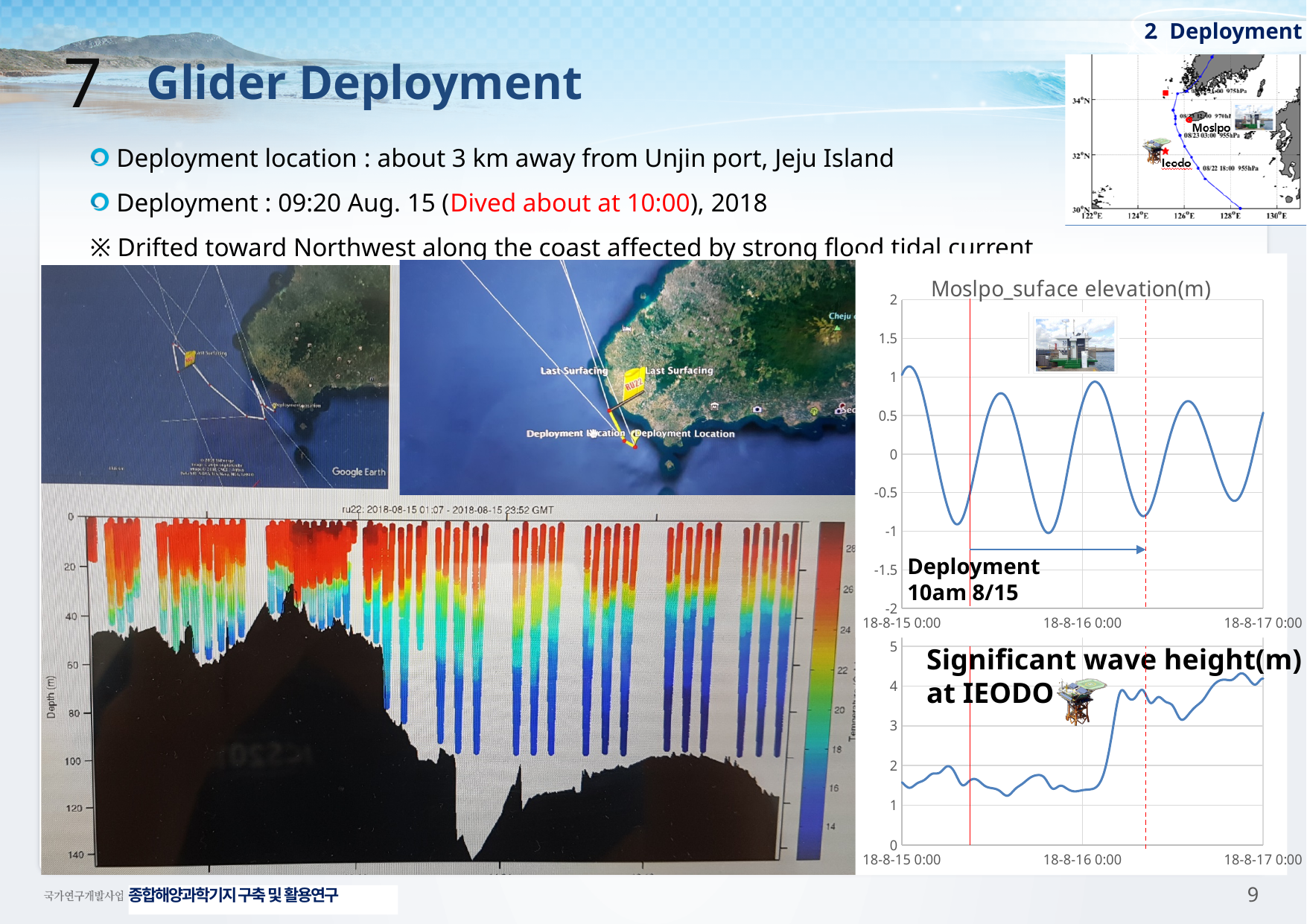
What is the title of the upper line chart on the right side of the slide? Moslpo_suface elevation(m) In the 'Moslpo_suface elevation(m)' chart, is the value at 18-8-15 0:00 greater or less than 0.5? greater What is the highest value shown on the y axis of the 'Significant wave height(m) at IEODO' chart? 5 In the 'Significant wave height(m) at IEODO' chart, do the values overall rise or fall from 18-8-15 0:00 to 18-8-17 0:00? rise What kind of chart is the 'Moslpo_suface elevation(m)' chart? line chart In the 'Moslpo_suface elevation(m)' chart, is the value at 18-8-16 0:00 greater or less than 0? greater How many line charts are shown on the right side of the slide? 2 In the 'Significant wave height(m) at IEODO' chart, is the value at 18-8-15 0:00 greater or less than 2? less What kind of chart is the 'Significant wave height(m) at IEODO' chart? line chart